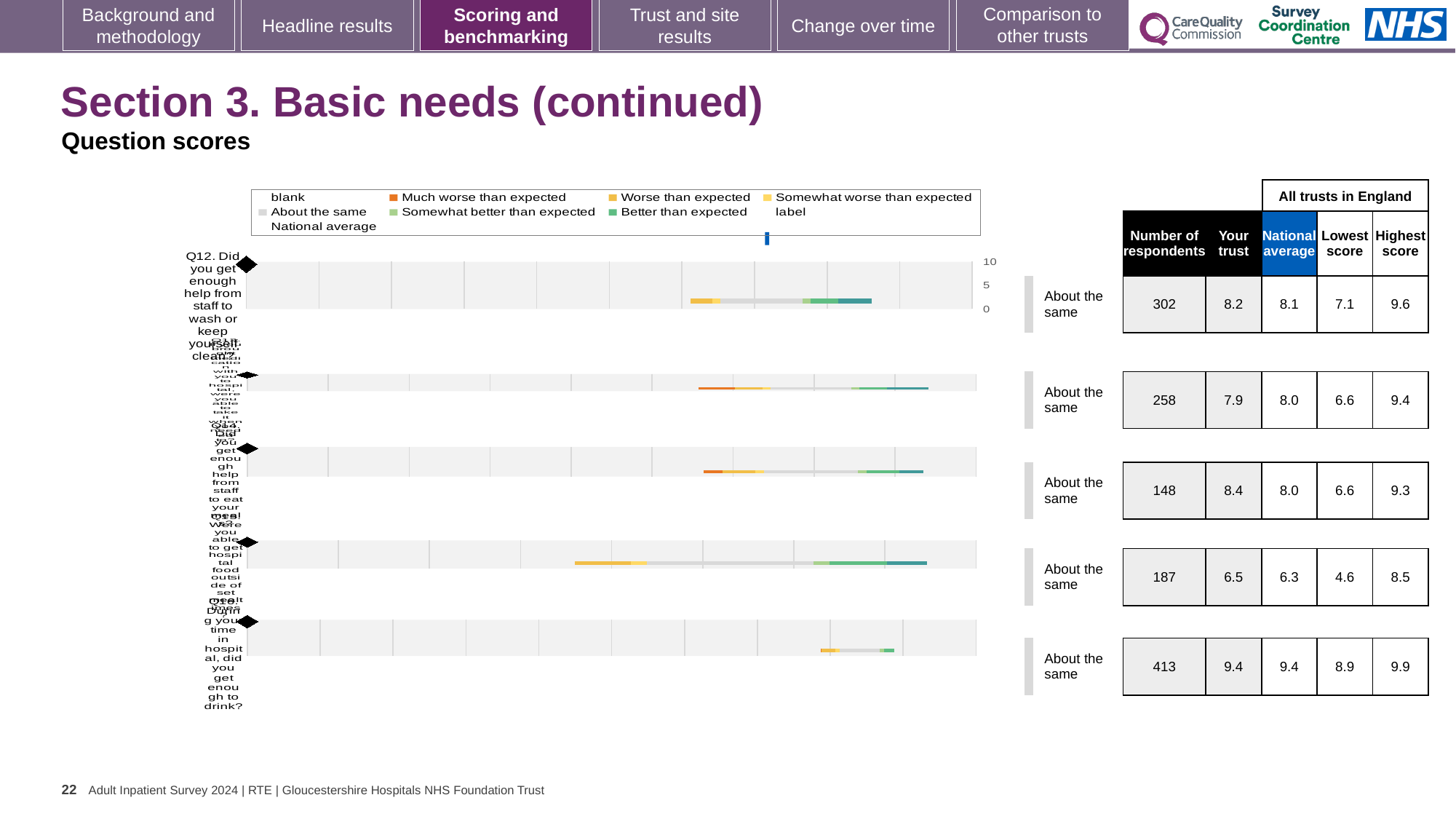
How many entries does the chart legend list? 9 What benchmark category is shown for Q12? About the same Which question has the highest 'Your trust' score? Q16 What is the 'Your trust' score for Q12? 8.2 How many questions (rows) are plotted in the chart? 5 For Q14, which is larger: the 'Your trust' score or the national average? Your trust What is the lowest score among all trusts in England for Q15? 4.6 Which question has the lowest 'Your trust' score? Q15 What is the difference between the 'Your trust' score and the national average for Q12? 0.1 What is the number of respondents for Q12 (Did you get enough help from staff to wash or keep yourself clean)? 302 What is the highest score among all trusts in England for Q16? 9.9 What kind of chart is shown on the slide? bar chart